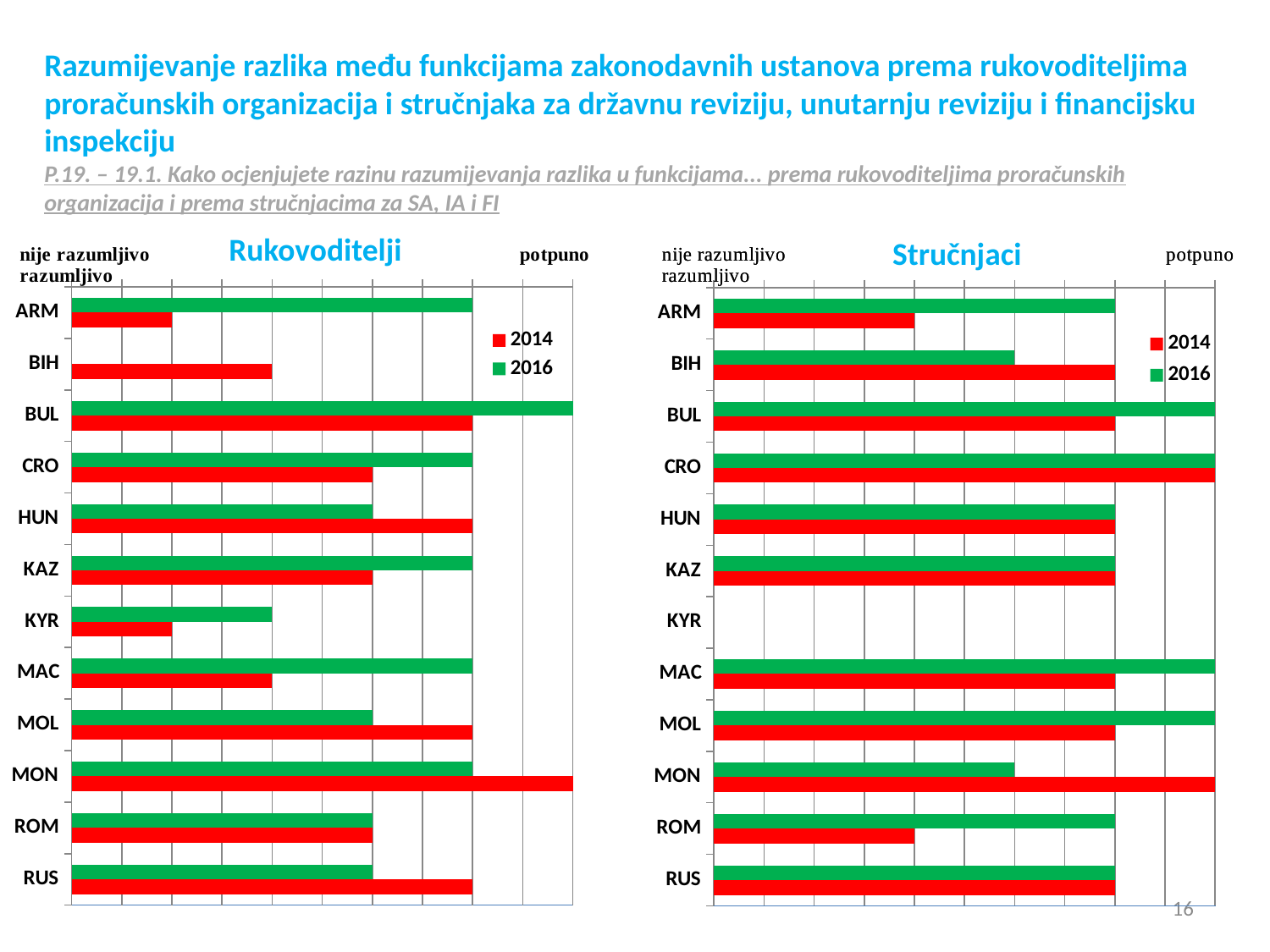
On the Rukovoditelji chart, is the HUN bar for 2014 or for 2016 longer? 2014 On the Rukovoditelji chart, which country has the longest 2014 bar? MON On the Rukovoditelji chart, which country has the longest 2016 bar? BUL On the Stručnjaci chart, is the ROM bar for 2014 or for 2016 longer? 2016 Which years are listed in the legend of the Rukovoditelji chart? 2014 and 2016 On the Rukovoditelji chart, is the ARM bar for 2014 or for 2016 longer? 2016 What kind of chart is the Rukovoditelji chart? bar chart What colour represents the 2014 series on the Stručnjaci chart? red How many countries are listed on the Rukovoditelji chart? 12 How many series does the legend of the Stručnjaci chart list? 2